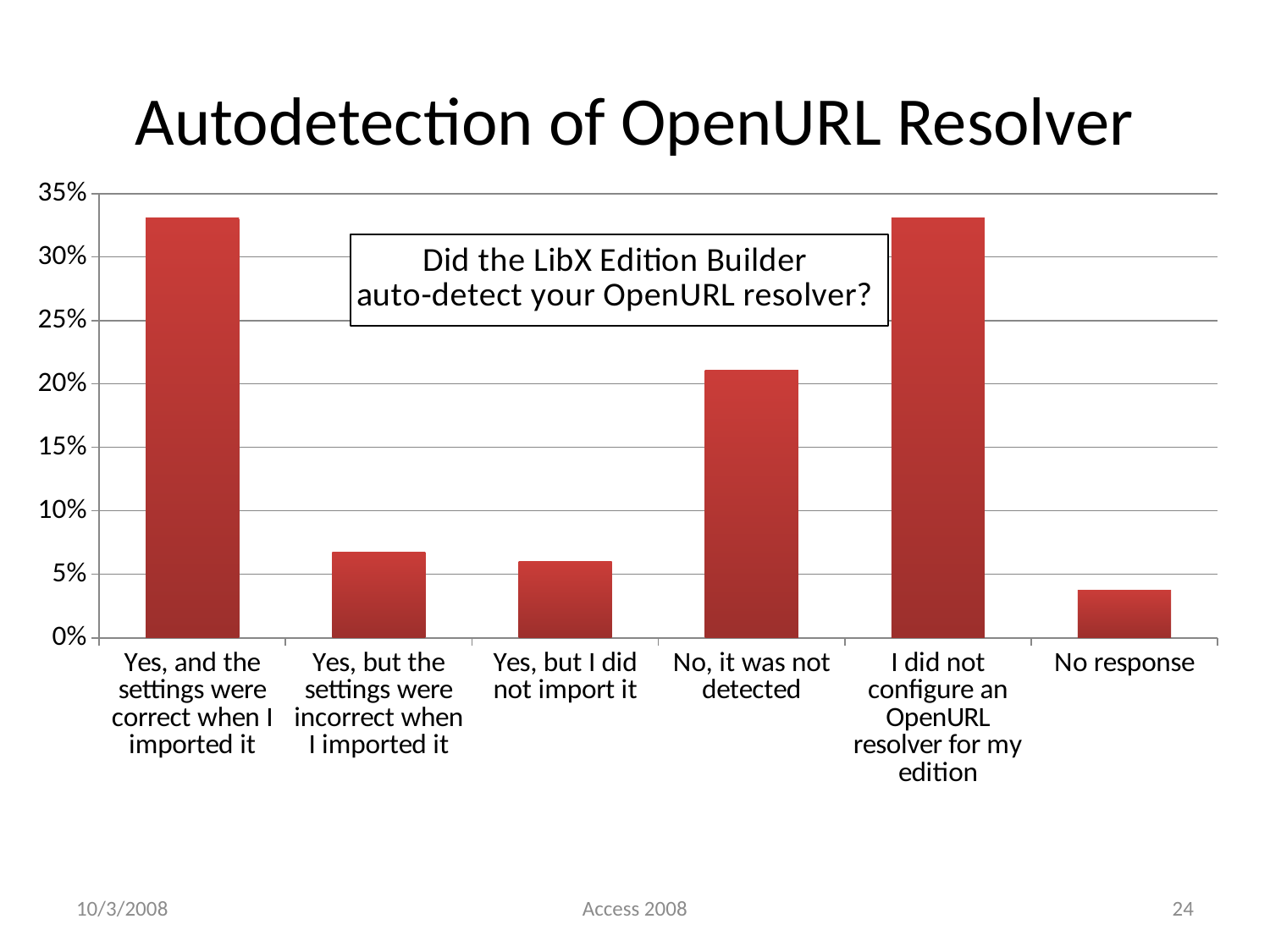
Which is larger: the value for "No, it was not detected" or the value for "Yes, but I did not import it"? No, it was not detected Is the value for "No response" greater or less than 5%? less Is the value for "Yes, but the settings were incorrect when I imported it" greater or less than 5%? greater How many categories are shown on the x axis of the chart? 6 Is the value for "No, it was not detected" greater or less than 20%? greater What is the title of the chart on the slide? Autodetection of OpenURL Resolver Which is larger: the value for "I did not configure an OpenURL resolver for my edition" or the value for "No response"? I did not configure an OpenURL resolver for my edition What survey question is shown in the text box on the chart? Did the LibX Edition Builder auto-detect your OpenURL resolver? Which category has the lowest value in the chart? No response What kind of chart is shown on the slide? bar chart